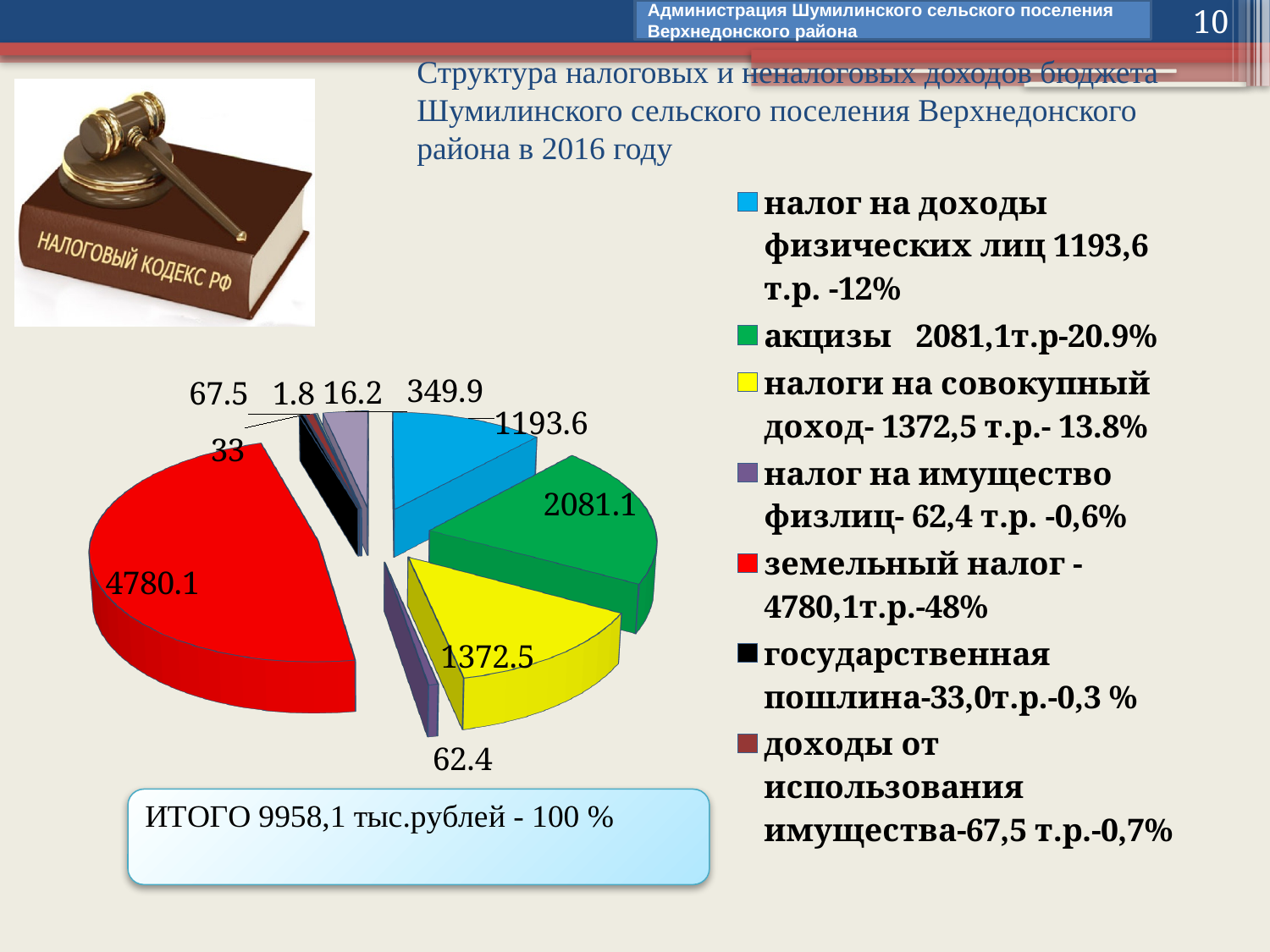
What share of the total does земельный налог represent according to the legend? 48% Which is larger: the slice for акцизы or the slice for налоги на совокупный доход? акцизы Which category has the largest slice in the pie chart? земельный налог How many entries does the legend list? 7 What is the value of the slice for налог на имущество физлиц? 62.4 How many data labels are shown on the pie chart? 10 What is the smallest data label value shown on the pie chart? 1.8 What is the value of the slice for налог на доходы физических лиц? 1193.6 What type of chart is shown on the slide? pie chart What is the value of the slice for акцизы? 2081.1 What is the difference between the земельный налог slice and the акцизы slice? 2699 What is the difference between the акцизы slice and the налоги на совокупный доход slice? 708.6